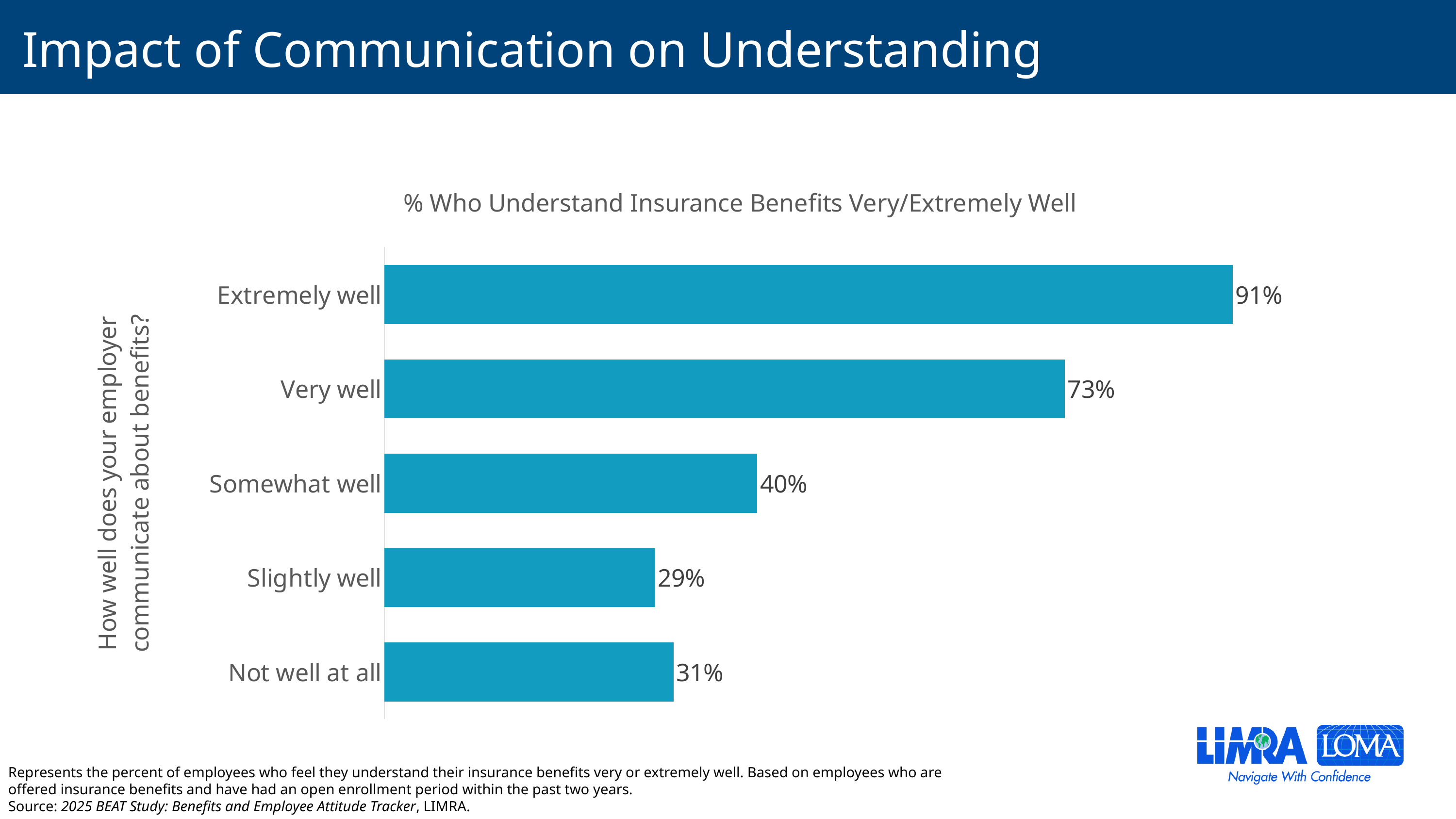
What percentage of employees whose employer communicates about benefits extremely well understand their insurance benefits very/extremely well? 91% What is the title of the chart? % Who Understand Insurance Benefits Very/Extremely Well Which category has the lowest value in the chart? Slightly well What is the value for the 'Not well at all' category? 31% How many categories are shown in the chart? 5 Which category has the highest percentage of employees who understand their insurance benefits very/extremely well? Extremely well What is the value for the 'Somewhat well' category? 40% What is the value for the 'Very well' category? 73% What kind of chart is shown on the slide? Bar chart Which has a larger value, 'Not well at all' or 'Slightly well'? Not well at all What is the difference between the values for 'Extremely well' and 'Very well'? 18% What is the difference between the values for 'Somewhat well' and 'Slightly well'? 11%